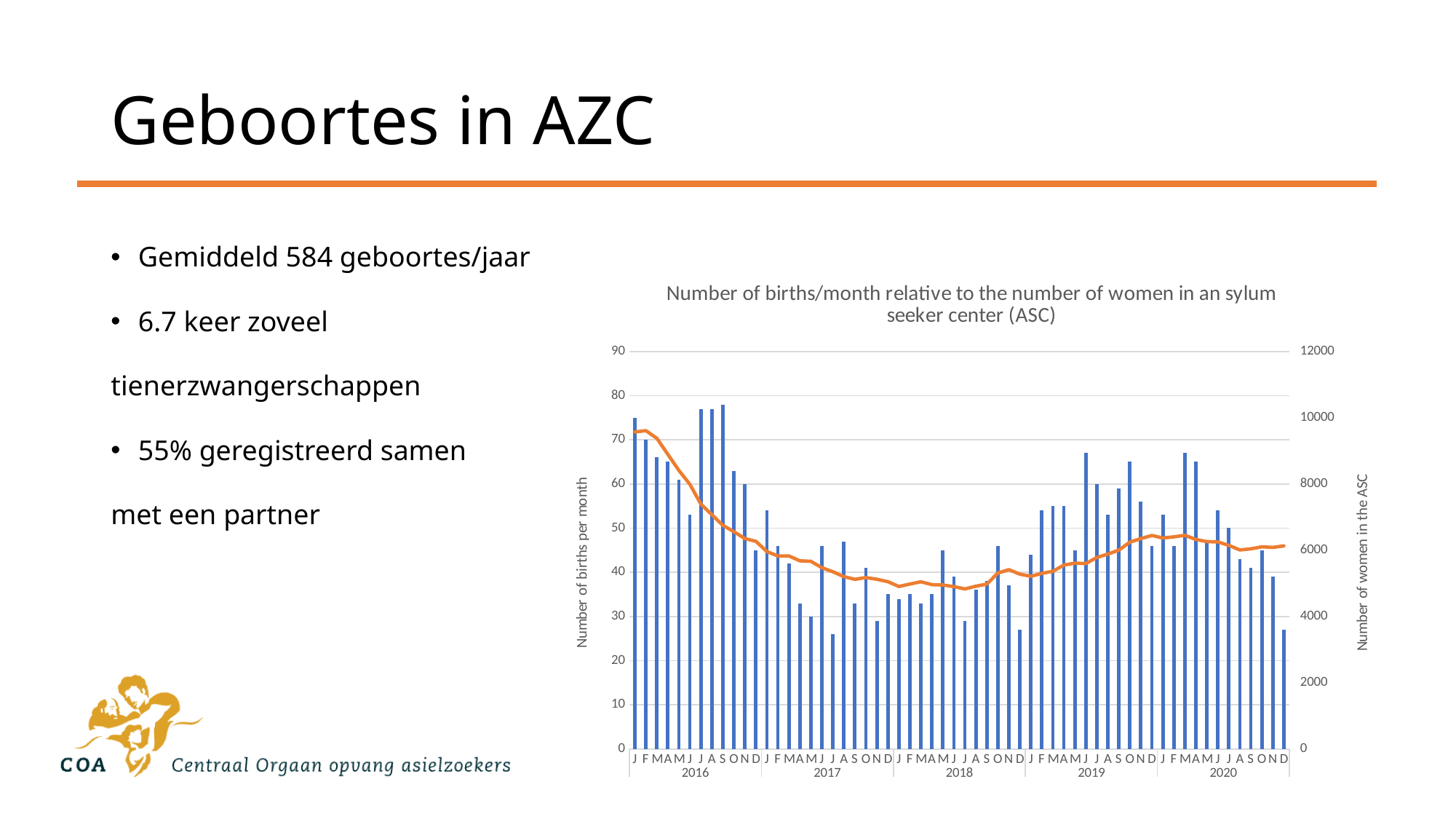
Is the number of women in the ASC (orange line) at the start of 2016 greater or less than 8000? greater Is the number of births per month for December 2020 greater or less than 30? less What is the label of the right-hand vertical axis of the chart? Number of women in the ASC Does the number of women in the ASC (orange line) rise or fall over the course of 2019? rise Does the number of women in the ASC (orange line) rise or fall over the course of 2016? fall Which is larger: the number of births per month in January 2016 or in December 2020? January 2016 What kind of chart is shown on the slide? A combined bar and line chart In which year does the chart show the highest monthly number of births? 2016 Is the number of births per month for January 2016 greater or less than 70? greater What is the title of the chart? Number of births/month relative to the number of women in an sylum seeker center (ASC) How many years are shown along the x axis of the chart? 5